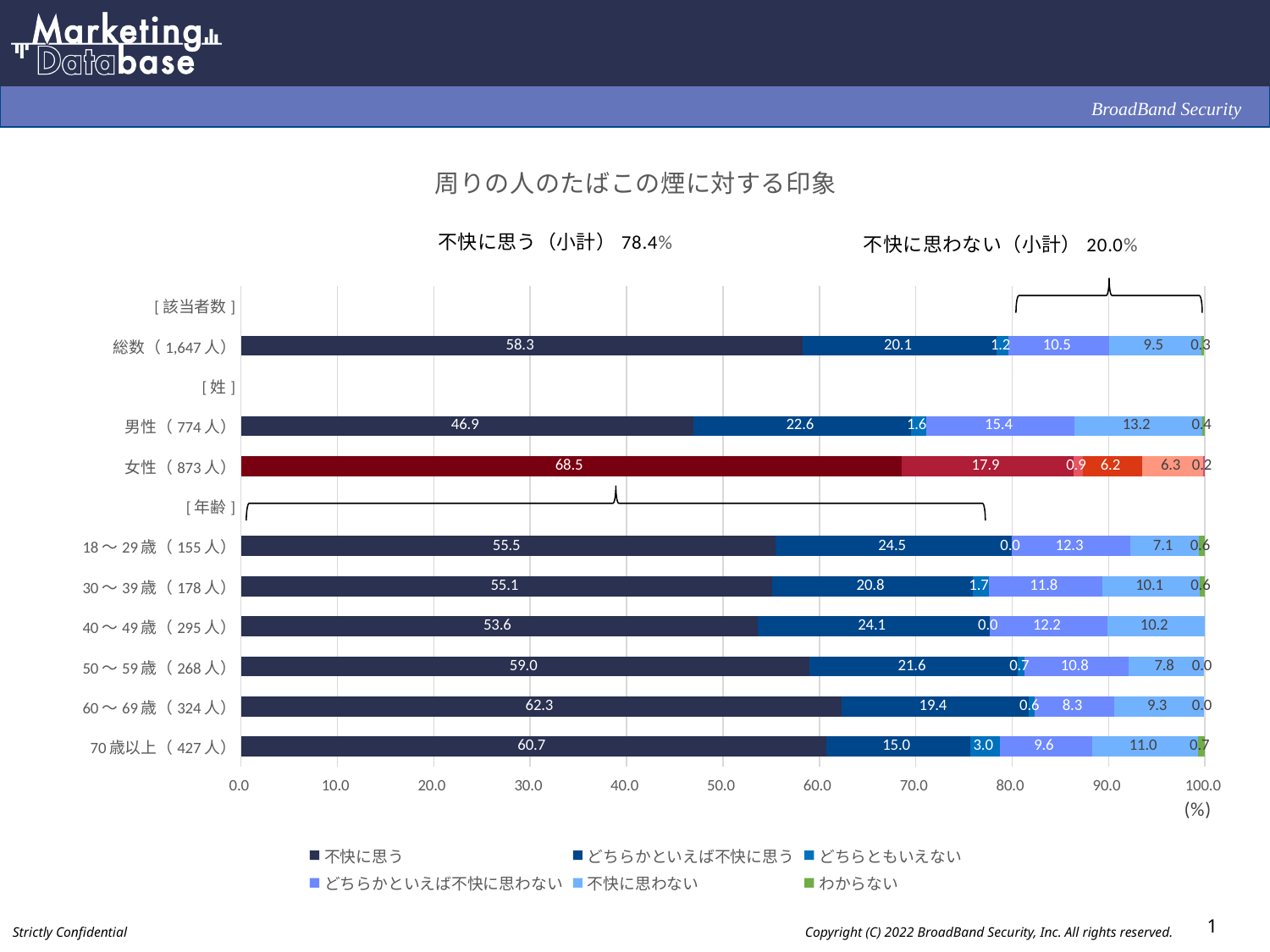
What is the value of どちらかといえば不快に思わない for 男性 (774人)? 15.4 How many series does the legend list? 6 What is the value of 不快に思う for 総数 (1,647人)? 58.3 Which group has the highest value for 不快に思う? 女性 (873人) What is the 不快に思わない (小計) percentage shown above the chart? 20.0% Which group has the lowest value for 不快に思う? 男性 (774人) What kind of chart is shown on the slide? stacked bar chart Which is larger, the どちらかといえば不快に思う value for 18〜29歳 (155人) or for 70歳以上 (427人)? 18〜29歳 (155人) What is the title of the chart? 周りの人のたばこの煙に対する印象 What is the value of どちらともいえない for 70歳以上 (427人)? 3.0 How many respondent groups (bars) are plotted in the chart? 9 What is the difference between the 不快に思う values for 女性 (873人) and 男性 (774人)? 21.6